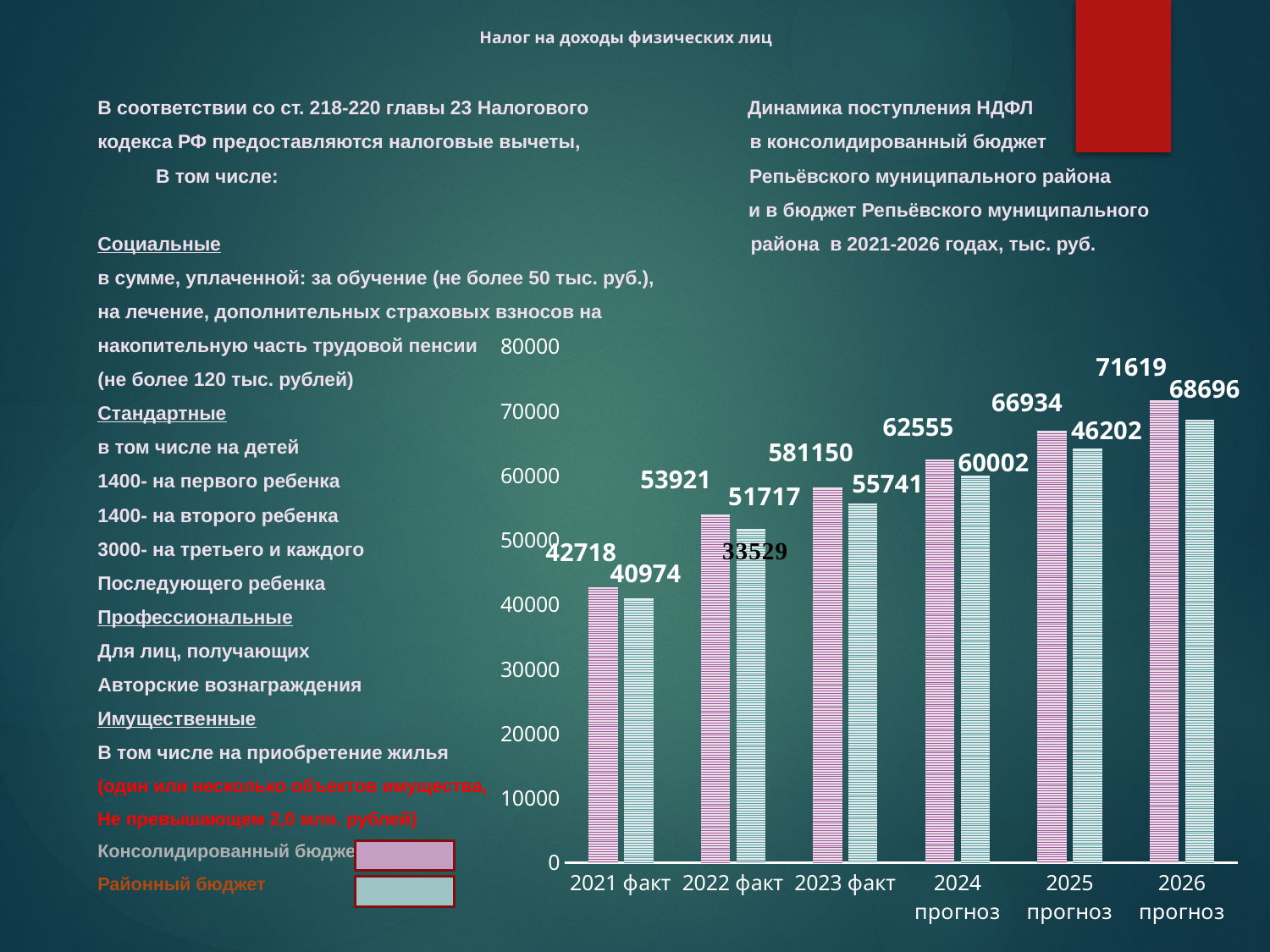
What is the value for Районный бюджет in 2026 прогноз? 68696 In which year is the Консолидированный бюджет value highest? 2026 прогноз What is the value for Консолидированный бюджет in 2024 прогноз? 62555 What is the value for Консолидированный бюджет in 2021 факт? 42718 In which year is the Консолидированный бюджет value lowest? 2021 факт What is the value for Районный бюджет in 2021 факт? 40974 Which is larger: Консолидированный бюджет in 2024 прогноз or Консолидированный бюджет in 2025 прогноз? 2025 прогноз Do the Консолидированный бюджет values rise or fall from 2021 факт to 2026 прогноз? rise How many series does the chart legend list? 2 How many year categories are shown on the x axis of the chart? 6 What is the difference between Консолидированный бюджет and Районный бюджет in 2026 прогноз? 2923 What type of chart is shown on the slide? bar chart